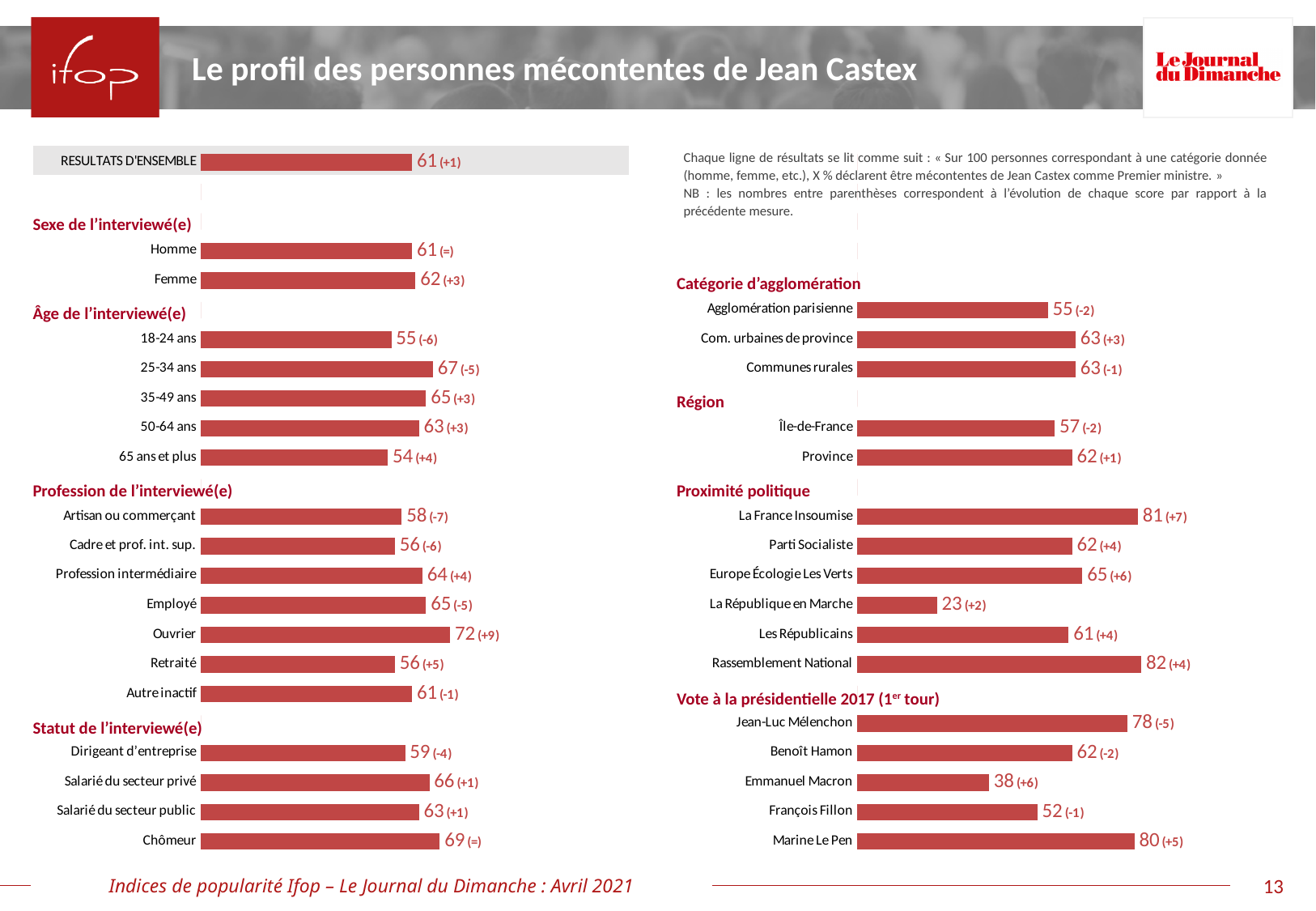
In the 'Profession de l'interviewé(e)' chart, what is the value for Ouvrier? 72 In the 'Proximité politique' chart, which category has the highest value? Rassemblement National In the 'Sexe de l'interviewé(e)' chart, which has the larger value, Homme or Femme? Femme What type of chart is used throughout this slide? Bar chart In the 'Profession de l'interviewé(e)' chart, what change from the previous measure is shown in parentheses for Ouvrier? +9 How many age categories are shown in the 'Âge de l'interviewé(e)' chart? 5 In the 'Proximité politique' chart, which category has the lowest value? La République en Marche In the 'Âge de l'interviewé(e)' chart, which age group has the highest value? 25-34 ans In the 'Vote à la présidentielle 2017 (1er tour)' chart, what is the difference between the values for Jean-Luc Mélenchon and Emmanuel Macron? 40 In the 'Résultats d'ensemble' bar at the top left, what is the overall score shown? 61 In the 'Statut de l'interviewé(e)' chart, what is the value for Chômeur? 69 In the 'Catégorie d'agglomération' chart, what is the value for Agglomération parisienne? 55